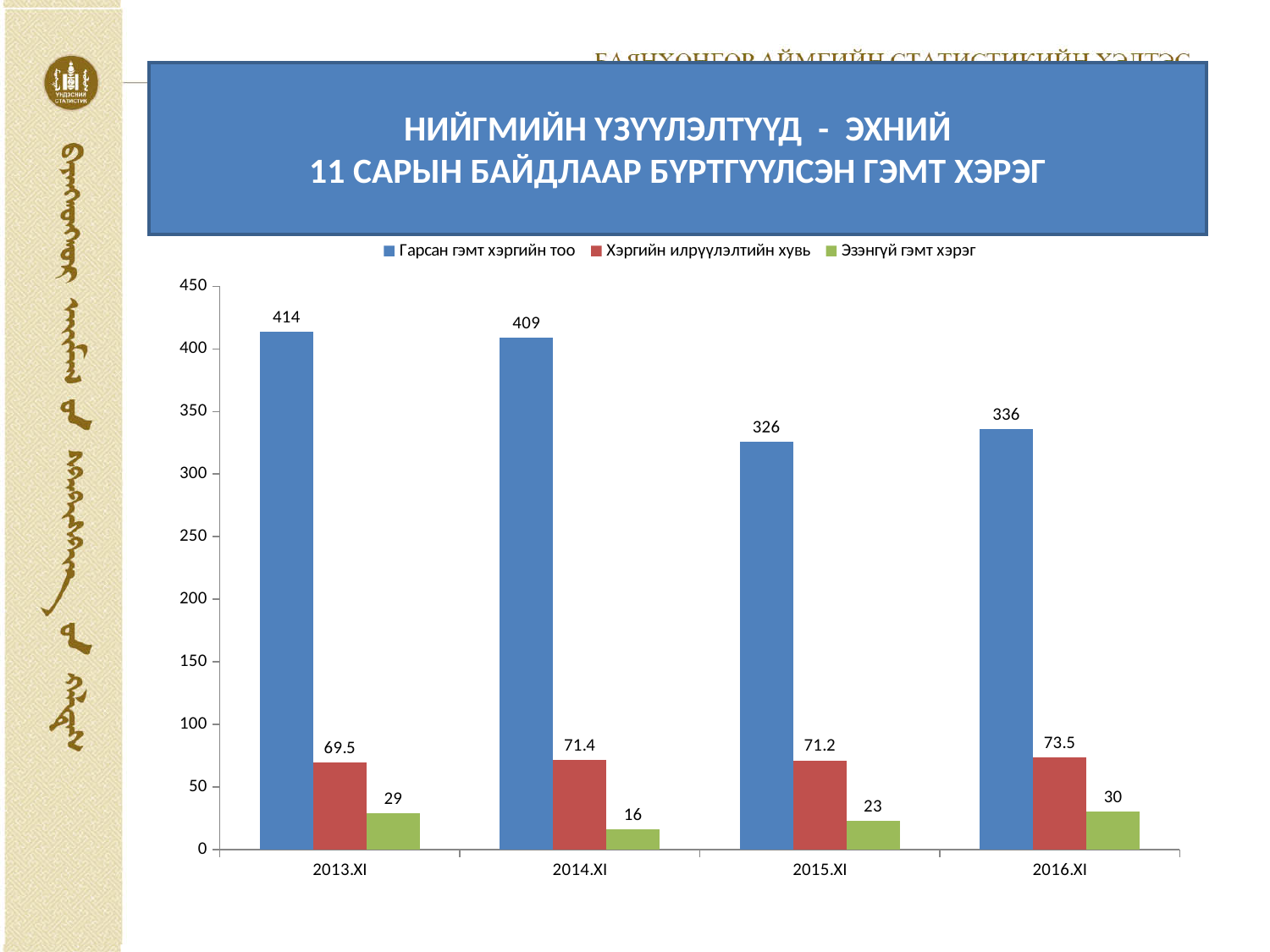
How many periods are shown on the x axis? 4 In which period is Эзэнгүй гэмт хэрэг the highest? 2016.XI Which colour represents Хэргийн илрүүлэлтийн хувь in the legend? red What is the difference between Гарсан гэмт хэргийн тоо in 2013.XI and 2015.XI? 88 What is the value of Хэргийн илрүүлэлтийн хувь for 2016.XI? 73.5 What is the value of Гарсан гэмт хэргийн тоо for 2013.XI? 414 What is the value of Эзэнгүй гэмт хэрэг for 2014.XI? 16 Which is larger: Эзэнгүй гэмт хэрэг in 2013.XI or in 2015.XI? 2013.XI Is the value of Гарсан гэмт хэргийн тоо for 2016.XI greater or less than 350? less In which period is Гарсан гэмт хэргийн тоо the lowest? 2015.XI What kind of chart is shown on the slide? bar chart How many series does the legend list? 3